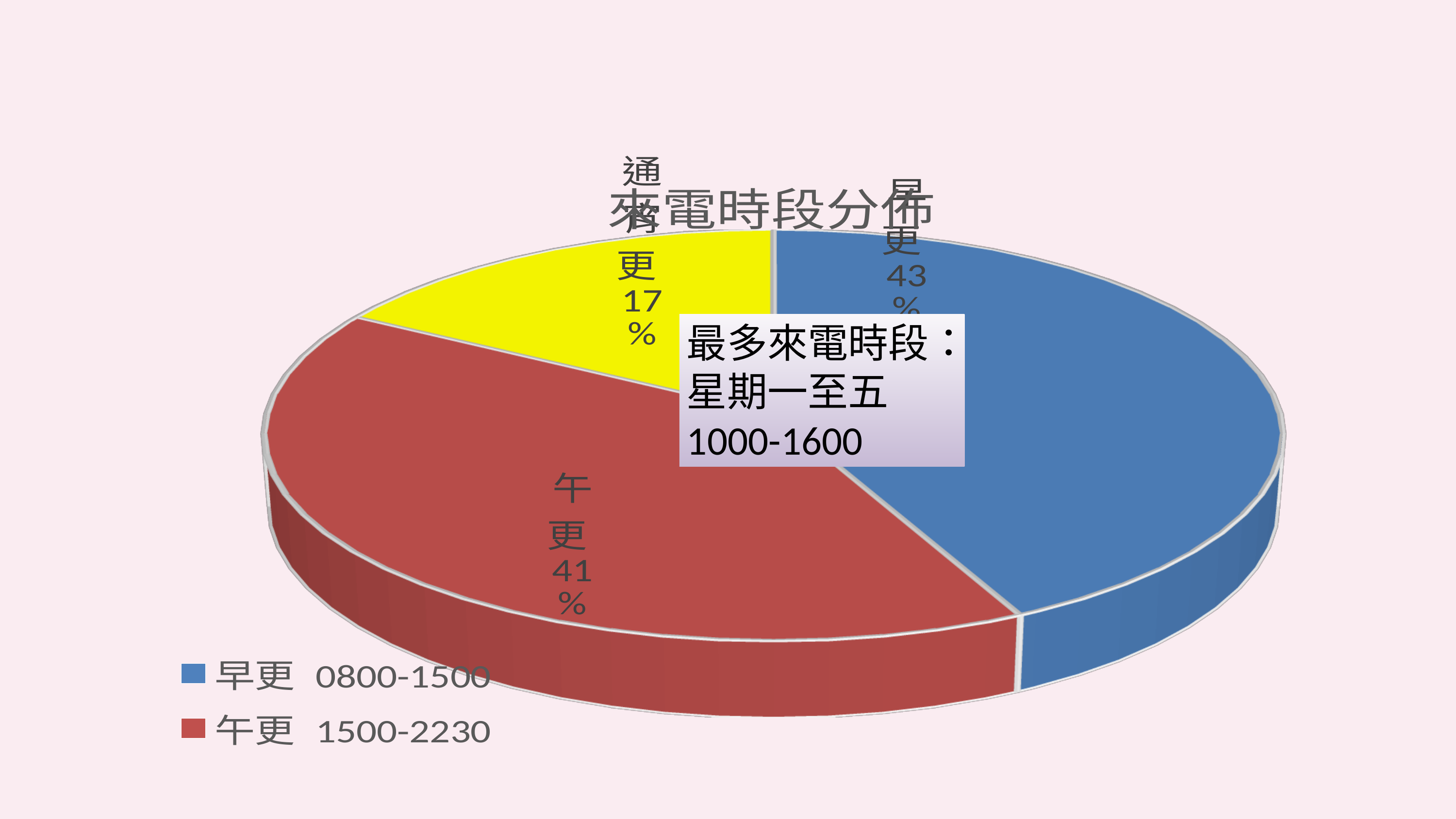
According to the legend, what hours does 午更 cover? 1500-2230 What is the title of the chart? 來電時段分佈 What kind of chart is shown on the slide? pie chart Which time slot has the smallest share of the pie? 通宵更 What percentage of the pie does 通宵更 account for? 17% What is the difference in percentage points between the 早更 and 午更 shares? 2 What percentage of the pie does 早更 account for? 43% How many slices does the pie chart have? 3 What is the difference in percentage points between the 早更 and 通宵更 shares? 26 Which has a larger share, 午更 or 通宵更? 午更 Which time slot has the largest share of the pie? 早更 What percentage of the pie does 午更 account for? 41%